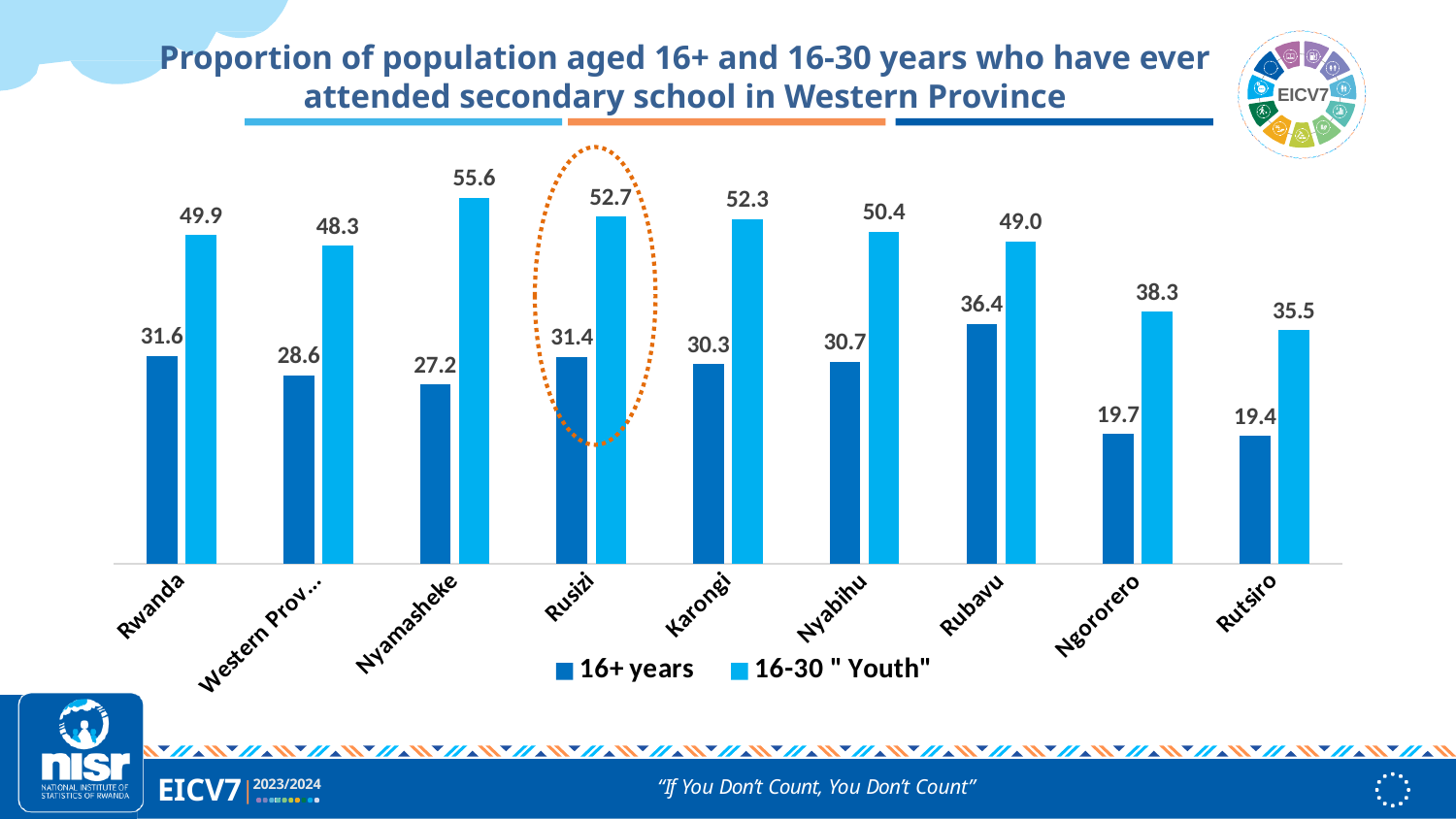
Which category has the highest value for the 16-30 "Youth" series? Nyamasheke Which category is highlighted with a dotted orange oval? Rusizi What is the value for the 16+ years series in Rubavu? 36.4 What is the difference between the 16-30 "Youth" value and the 16+ years value for Rusizi? 21.3 How many categories are shown on the x axis? 9 What kind of chart is shown on the slide? Bar chart What is the value for the 16-30 "Youth" series in Nyamasheke? 55.6 How many series does the legend list? 2 Which category has the highest value for the 16+ years series? Rubavu Which is larger: the 16+ years value for Rwanda or the 16+ years value for Ngororero? Rwanda What is the value for the 16+ years series in Rusizi? 31.4 Which category has the lowest value for the 16-30 "Youth" series? Rutsiro